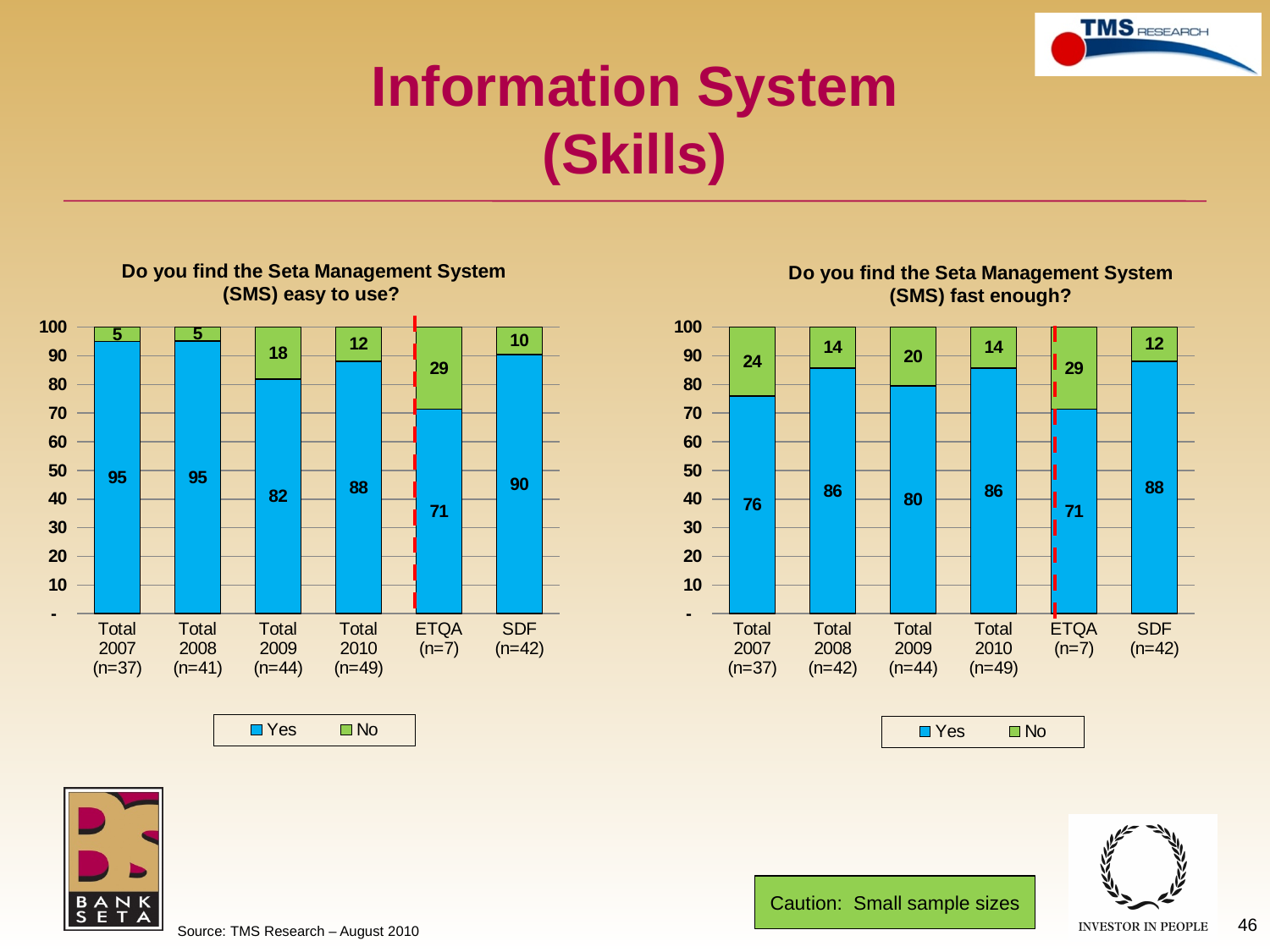
In the 'fast enough' chart on the right, what is the Yes value for Total 2007 (n=37)? 76 How many categories are shown on the x axis of the 'easy to use' chart on the left? 6 In the 'easy to use' chart on the left, what is the Yes value for ETQA (n=7)? 71 In the 'fast enough' chart on the right, what is the No value for SDF (n=42)? 12 In the 'easy to use' chart on the left, what is the difference between the Yes values for Total 2007 and Total 2009? 13 In the 'fast enough' chart on the right, is the Yes value for Total 2008 larger or smaller than the Yes value for Total 2009? larger In the 'fast enough' chart on the right, which category has the highest No value? ETQA (n=7) How many series does the legend of the 'fast enough' chart on the right list? 2 In the 'easy to use' chart on the left, what is the No value for Total 2009 (n=44)? 18 What type of chart is the 'easy to use' chart on the left? Stacked bar chart In the 'easy to use' chart on the left, which category has the lowest Yes value? ETQA (n=7) In the 'fast enough' chart on the right, what is the total of the stacked bar for Total 2010 (n=49)? 100